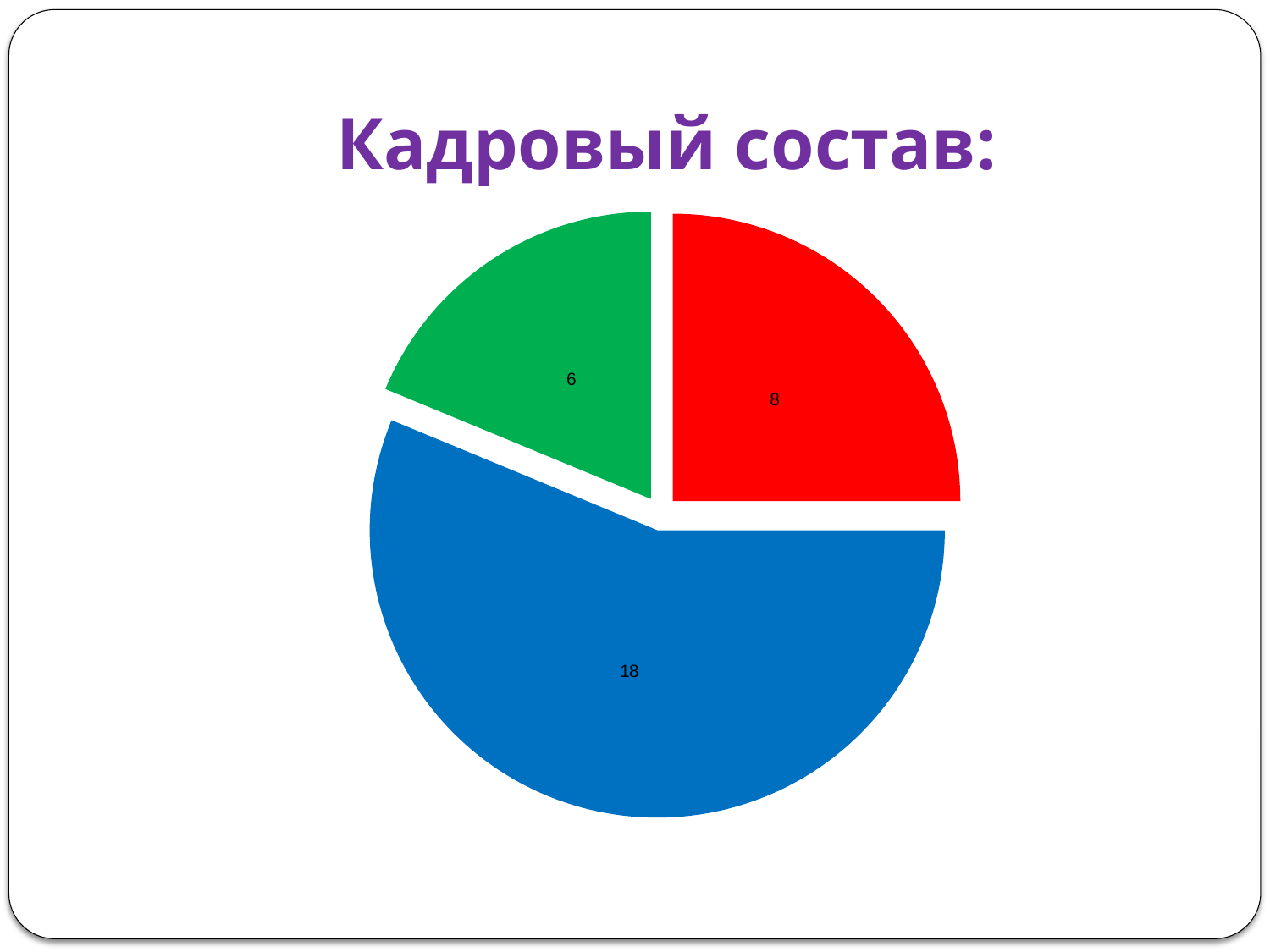
How many slices does the pie chart have? 3 What share of the pie does the red slice represent? 25% What is the difference between the values of the blue slice and the red slice? 10 What value is shown on the blue slice of the pie chart? 18 What value is shown on the red slice of the pie chart? 8 Which is larger, the value of the red slice or the value of the green slice? the red slice What value is shown on the green slice of the pie chart? 6 What is the title of the chart on the slide? Кадровый состав: Which slice of the pie chart has the largest value? the blue slice (18) What kind of chart is shown on the slide? pie chart Which slice of the pie chart has the smallest value? the green slice (6) What is the total of all the values shown on the pie chart? 32